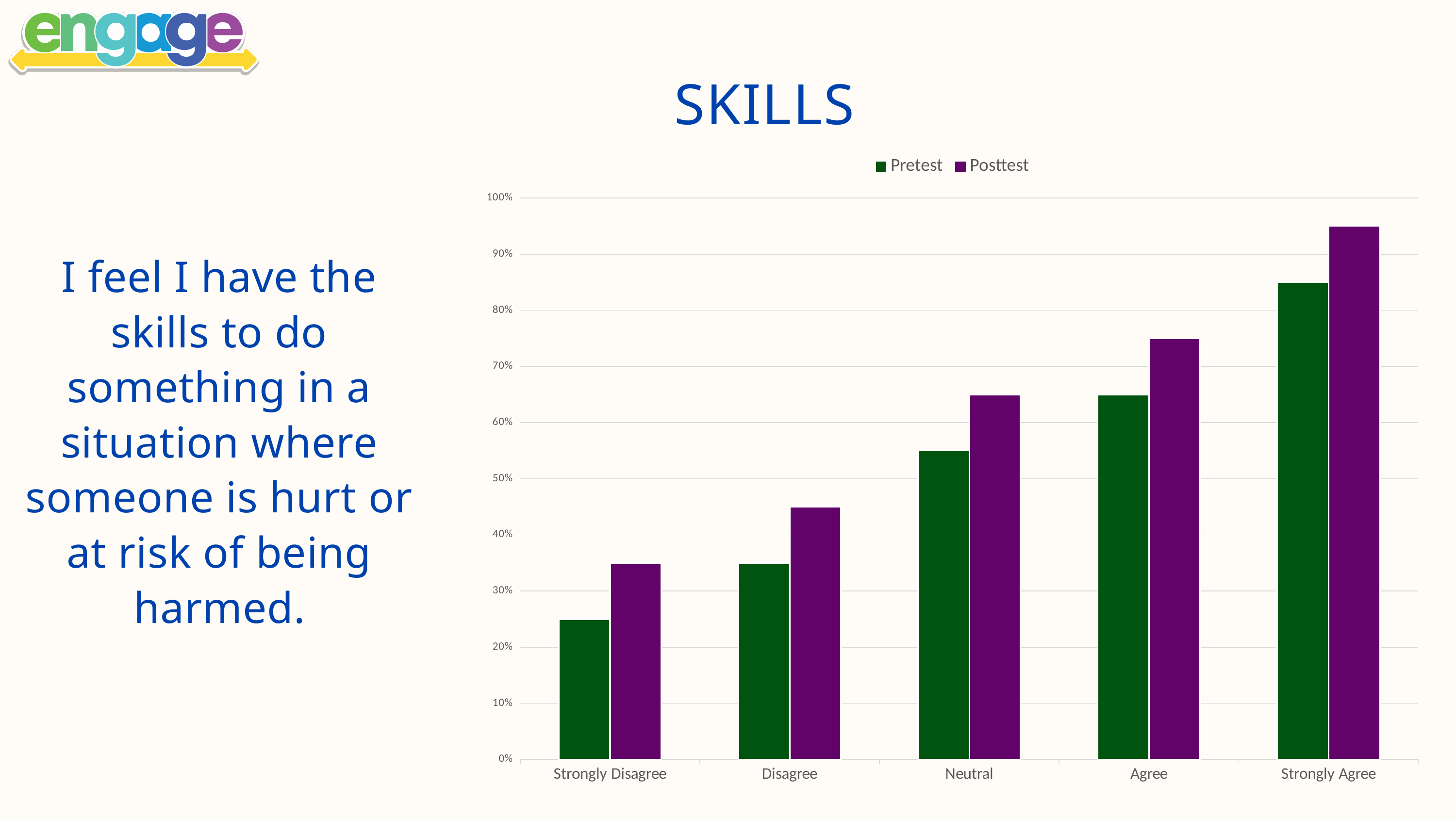
For Neutral, which is larger, the Pretest or the Posttest value? Posttest Which category has the highest Posttest value? Strongly Agree Is the Posttest value for Strongly Agree greater or less than 90%? greater Is the Pretest value for Strongly Disagree greater or less than 30%? less How many series does the legend list? 2 What kind of chart is shown on the slide? bar chart Is the Pretest value for Neutral greater or less than 50%? greater Do the Pretest values rise or fall moving from Strongly Disagree to Strongly Agree? rise What is the title of the chart? SKILLS Which category has the lowest Pretest value? Strongly Disagree How many categories are shown on the x axis? 5